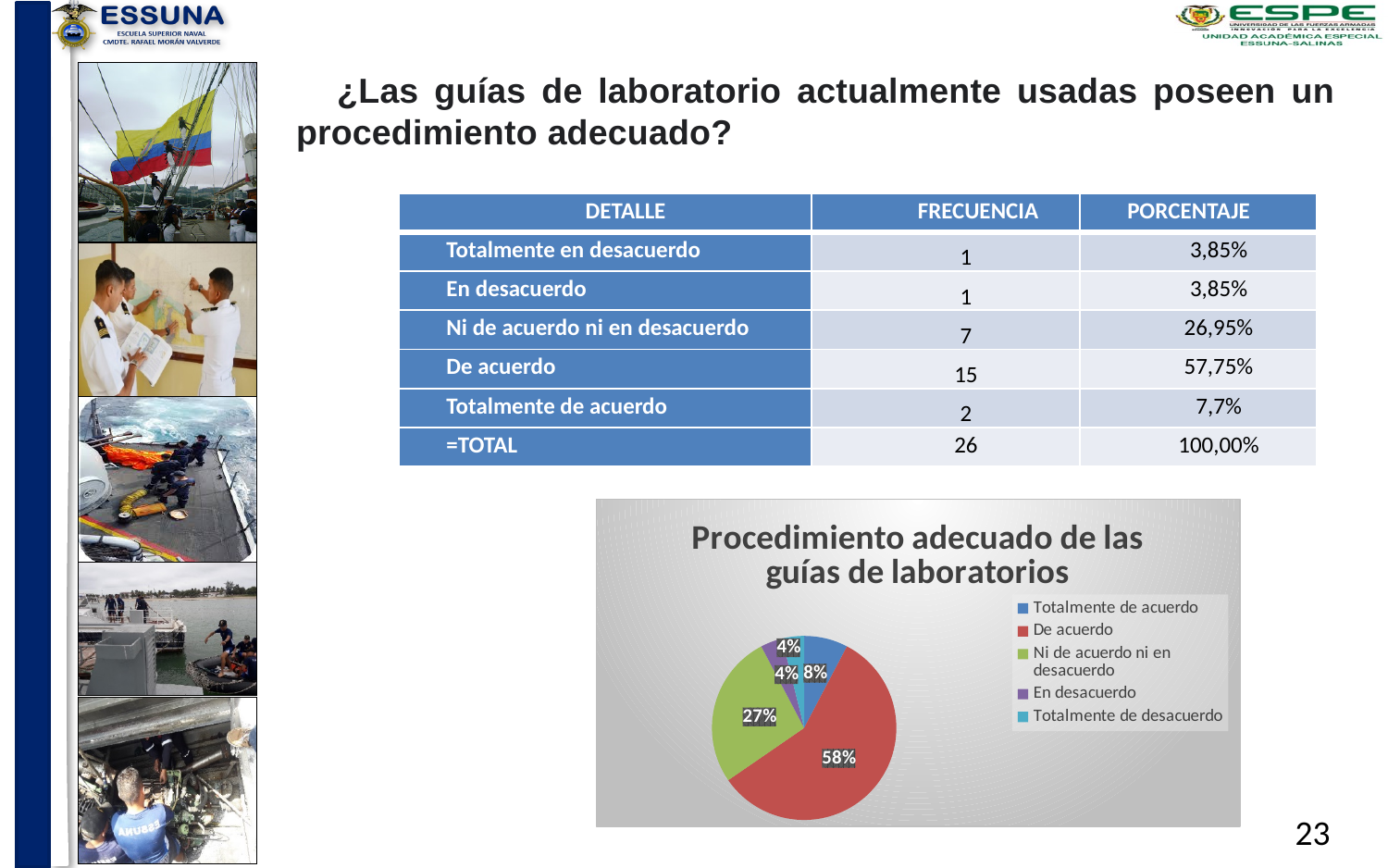
What type of chart is shown on the slide? Pie chart What is the title of the pie chart? Procedimiento adecuado de las guías de laboratorios In the pie chart, what is the difference in percentage points between "De acuerdo" and "Ni de acuerdo ni en desacuerdo"? 31 In the pie chart, which is larger: "Ni de acuerdo ni en desacuerdo" or "Totalmente de acuerdo"? Ni de acuerdo ni en desacuerdo In the pie chart, what percentage is shown for "En desacuerdo"? 4% How many entries does the legend of the pie chart list? 5 In the pie chart, what percentage is shown for "De acuerdo"? 58% What colour is the "De acuerdo" slice in the pie chart? Red In the pie chart, what percentage is shown for "Totalmente de acuerdo"? 8% How many slices does the pie chart have? 5 In the pie chart, what percentage is shown for "Ni de acuerdo ni en desacuerdo"? 27% Which category has the largest slice in the pie chart? De acuerdo